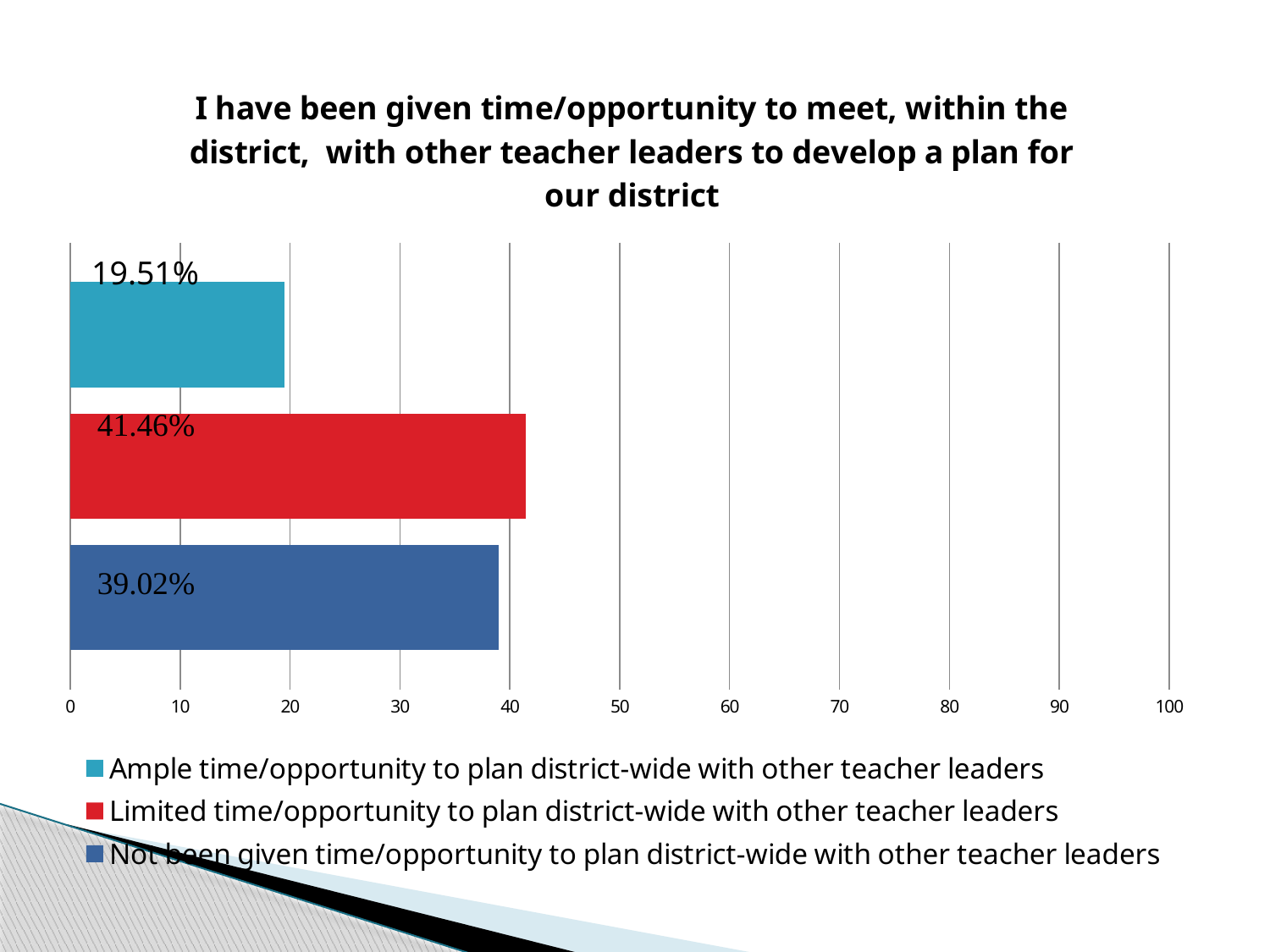
What is the value for "Ample time/opportunity to plan district-wide with other teacher leaders"? 19.51% How many bars are plotted on the chart? 3 Which response has the highest value? Limited time/opportunity to plan district-wide with other teacher leaders What is the difference between the values for "Limited time/opportunity" and "Not been given time/opportunity"? 2.44% Is the value for "Limited time/opportunity" greater or less than 40? greater Which response has the lowest value? Ample time/opportunity to plan district-wide with other teacher leaders Which is larger, the value for "Ample time/opportunity" or the value for "Not been given time/opportunity"? Not been given time/opportunity to plan district-wide with other teacher leaders What kind of chart is shown on the slide? Bar chart How many entries does the legend list? 3 What is the difference between the values for "Limited time/opportunity" and "Ample time/opportunity"? 21.95% What is the value for "Not been given time/opportunity to plan district-wide with other teacher leaders"? 39.02% What is the value for "Limited time/opportunity to plan district-wide with other teacher leaders"? 41.46%